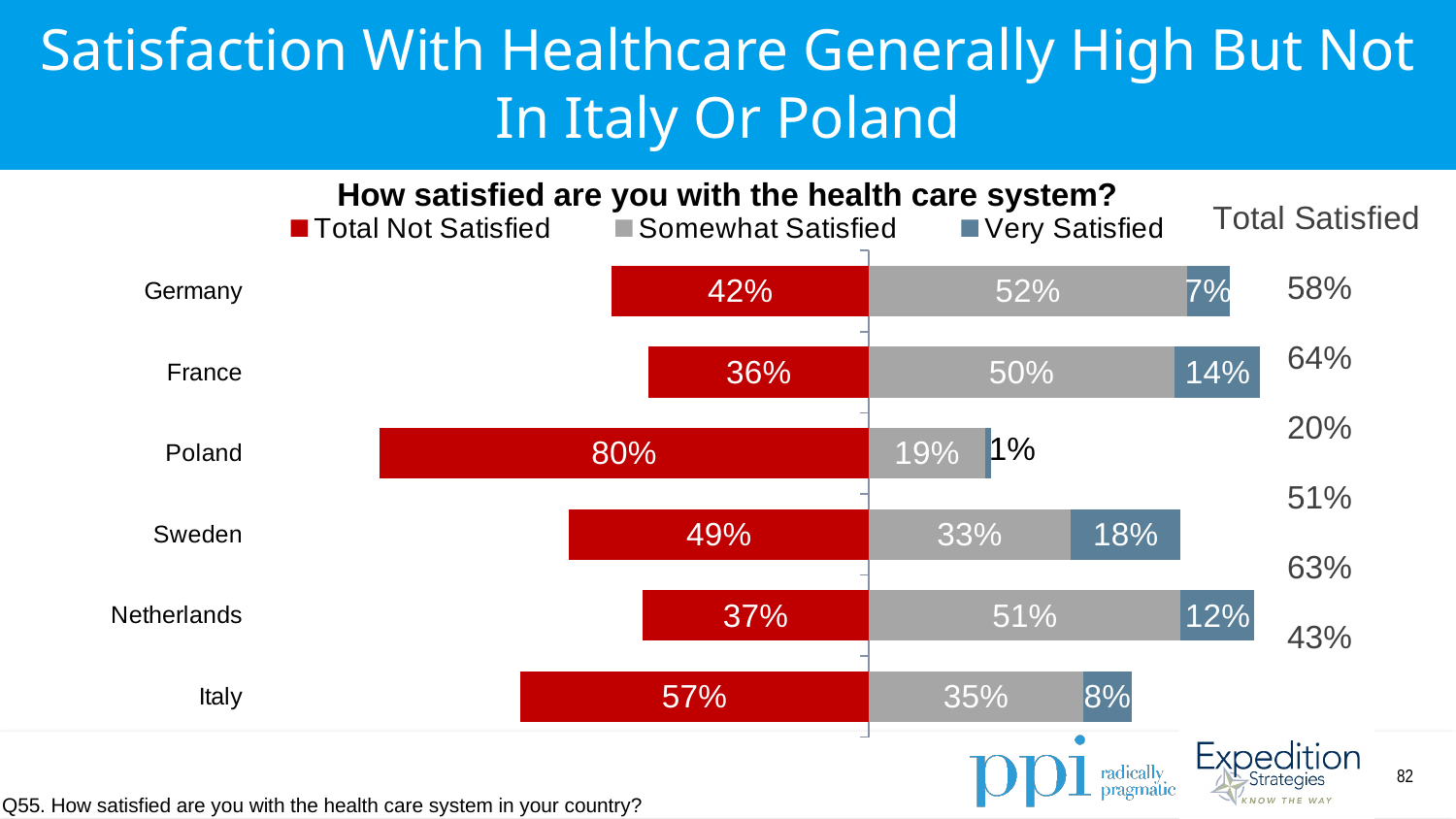
How many countries are shown in the chart? 6 What is the Total Satisfied figure shown for France? 64% How many series does the legend list? 3 Which is larger, the Very Satisfied value for France or for the Netherlands? France What is the Very Satisfied value for Sweden? 18% What kind of chart is shown on the slide? Stacked bar chart What is the difference between the Total Not Satisfied values for Italy and Germany? 15% What is the Somewhat Satisfied value for the Netherlands? 51% Which country has the lowest Very Satisfied value? Poland What is the Total Not Satisfied value for Poland? 80% Which country has the highest Total Not Satisfied value? Poland What is the title of the chart? How satisfied are you with the health care system?